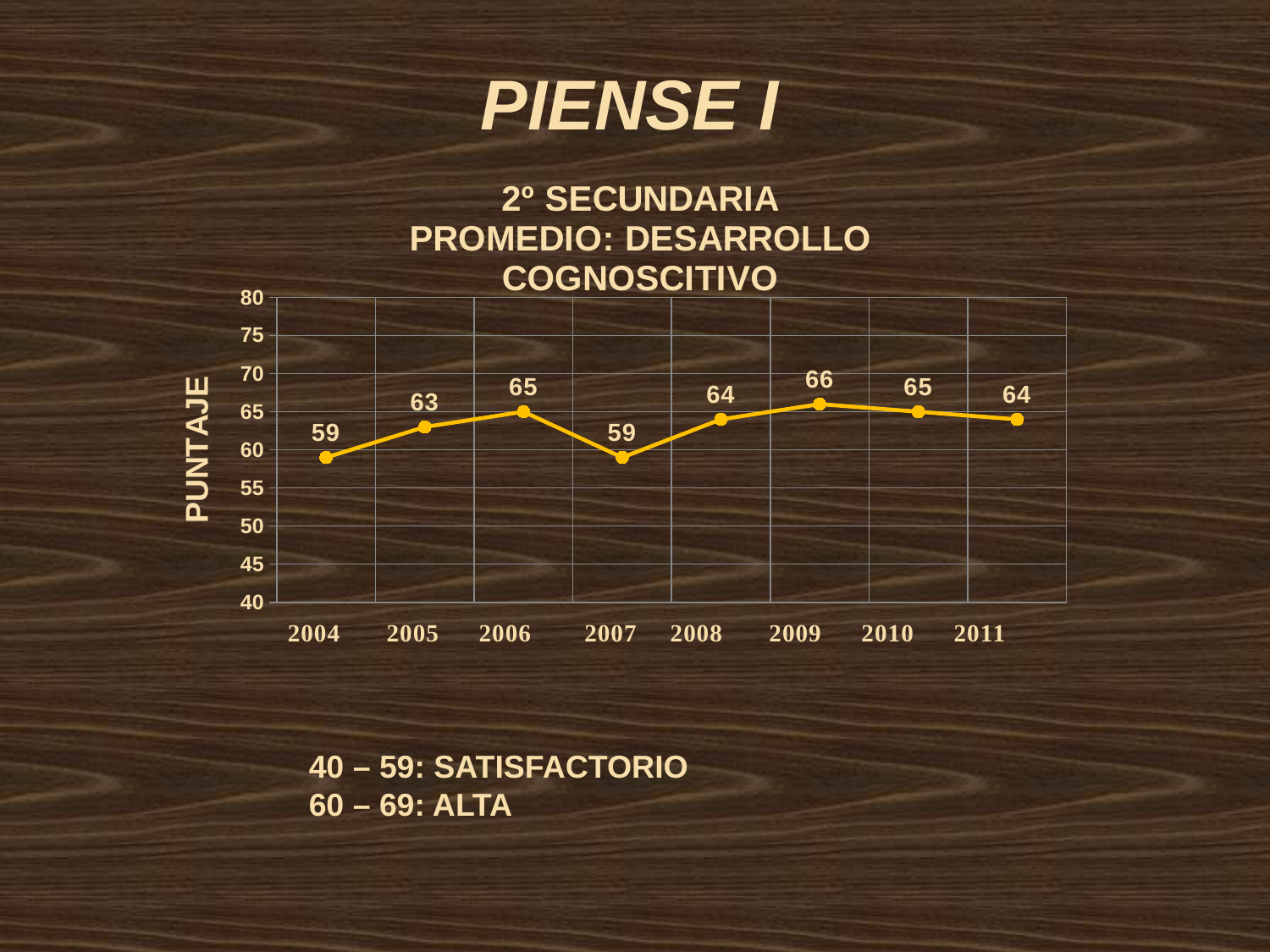
What is the difference between the values for 2009 and 2007? 7 What is the value for 2004? 59 What is the value for 2011? 64 Is the value for 2008 greater or less than 60? greater What is the difference between the values for 2005 and 2004? 4 What kind of chart is shown? line chart Which is larger, the value for 2005 or the value for 2006? 2006 What is the label on the y axis? PUNTAJE How many years are plotted on the x axis? 8 Which year has the highest value? 2009 Does the value rise or fall from 2006 to 2007? fall What is the value for 2009? 66